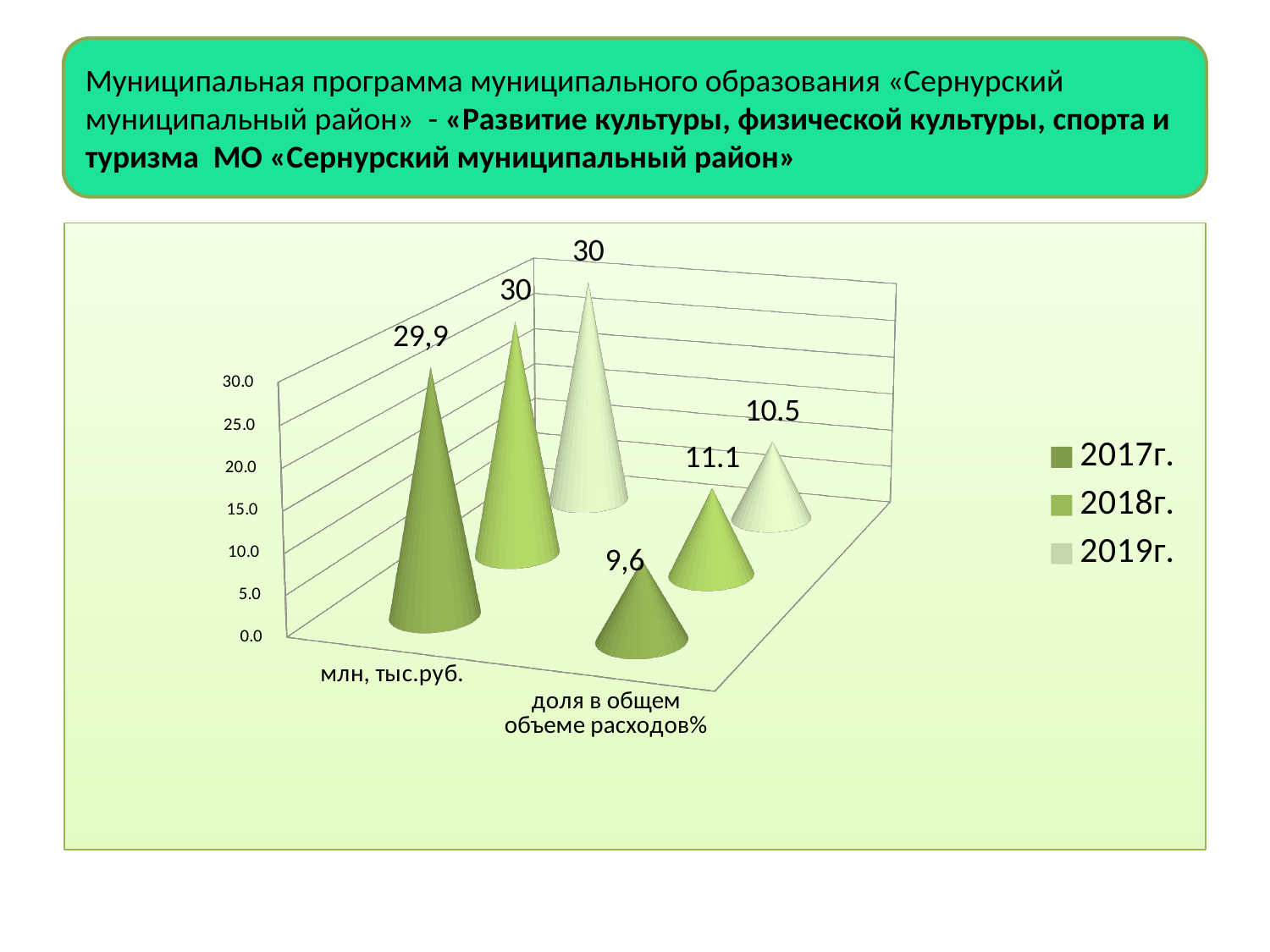
What is the value for 2018г. in the category «доля в общем объеме расходов%»? 11.1 Which year has the highest value in the category «доля в общем объеме расходов%»? 2018г. What is the value for 2017г. in the category «доля в общем объеме расходов%»? 9,6 Which year has the lowest value in the category «доля в общем объеме расходов%»? 2017г. What is the value for 2019г. in the category «млн, тыс.руб.»? 30 How many categories are shown on the x axis? 2 How many series does the legend list? 3 What is the value for 2019г. in the category «доля в общем объеме расходов%»? 10.5 What is the value for 2017г. in the category «млн, тыс.руб.»? 29,9 What is the difference between the 2018г. and 2019г. values in the category «доля в общем объеме расходов%»? 0.6 Which is larger: the 2017г. value or the 2018г. value in the category «доля в общем объеме расходов%»? 2018г. What kind of chart is shown on the slide? bar chart